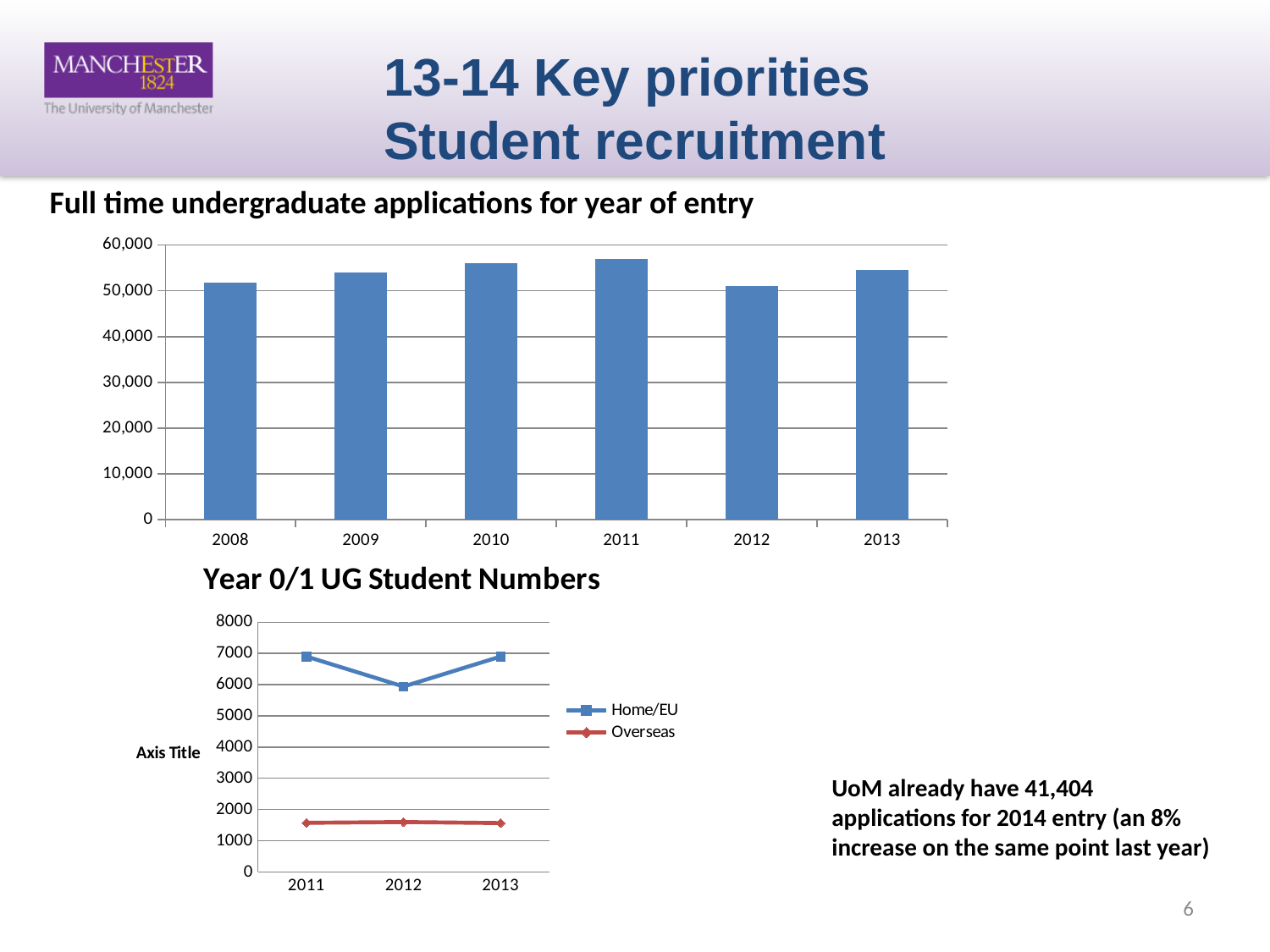
In the 'Year 0/1 UG Student Numbers' chart, which series is larger in 2012, Home/EU or Overseas? Home/EU What kind of chart is the 'Full time undergraduate applications for year of entry' chart? bar chart In the 'Year 0/1 UG Student Numbers' chart, is the Overseas value for 2012 greater or less than 2000? less In the 'Full time undergraduate applications for year of entry' chart, is the value for 2008 greater or less than 50,000? greater What kind of chart is the 'Year 0/1 UG Student Numbers' chart? line chart What are the two series named in the legend of the 'Year 0/1 UG Student Numbers' chart? Home/EU and Overseas In the 'Full time undergraduate applications for year of entry' chart, which is larger, the value for 2010 or the value for 2012? 2010 How many years are shown on the x axis of the 'Full time undergraduate applications for year of entry' chart? 6 How many series does the legend of the 'Year 0/1 UG Student Numbers' chart list? 2 In the 'Full time undergraduate applications for year of entry' chart, which year has the highest number of applications? 2011 In the 'Full time undergraduate applications for year of entry' chart, is the value for 2011 greater or less than 60,000? less